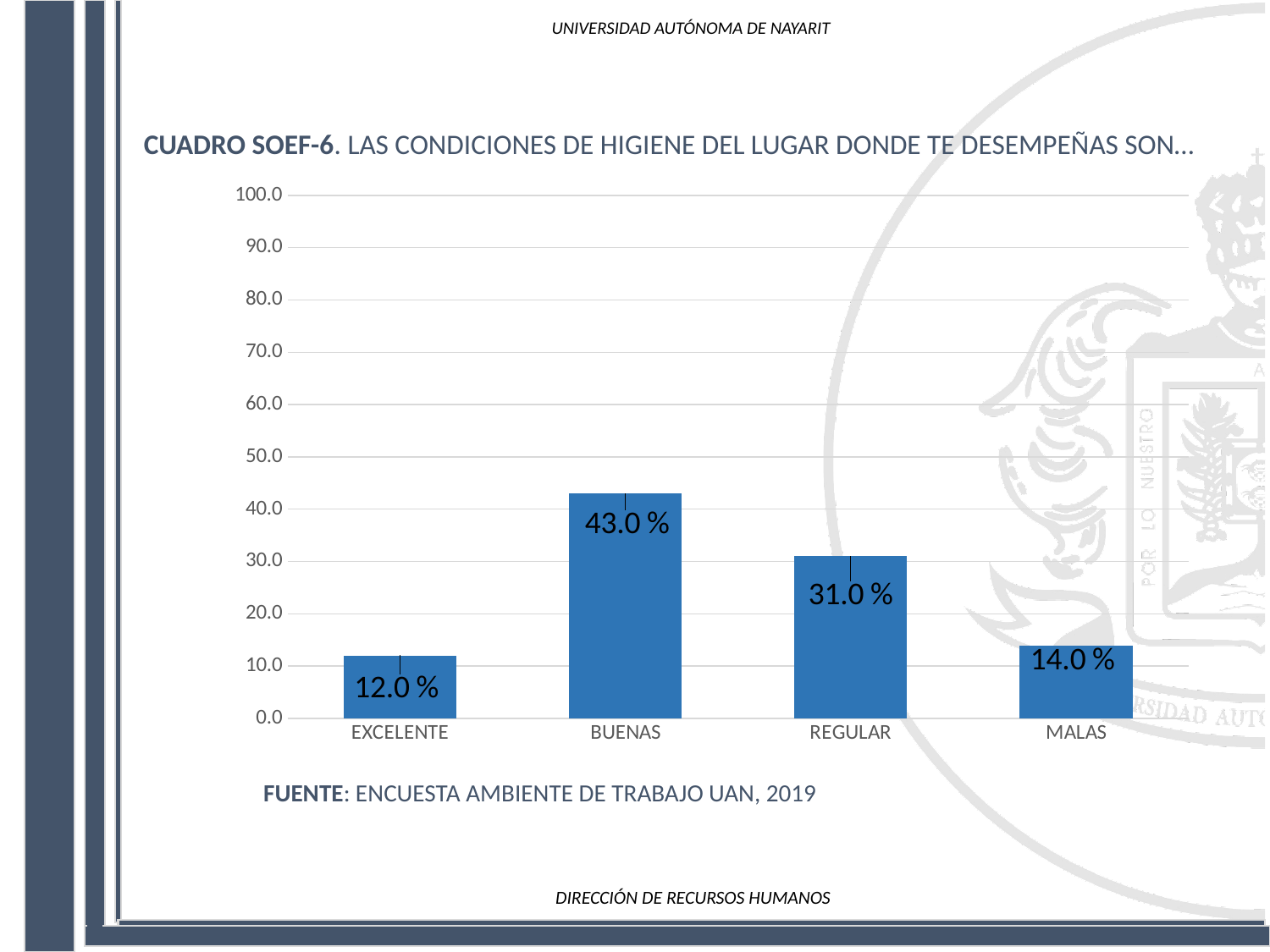
What is the highest value shown on the y axis? 100.0 How many categories are shown on the x axis? 4 Is the value for REGULAR greater or less than 20.0? greater What is the value for BUENAS? 43.0 % What is the difference between the values for BUENAS and REGULAR? 12.0 % What is the value for MALAS? 14.0 % What is the value for EXCELENTE? 12.0 % Which category has the highest value? BUENAS Which category has the lowest value? EXCELENTE Which is larger, the value for REGULAR or the value for MALAS? REGULAR What kind of chart is shown on the slide? bar chart What is the source cited below the chart? ENCUESTA AMBIENTE DE TRABAJO UAN, 2019